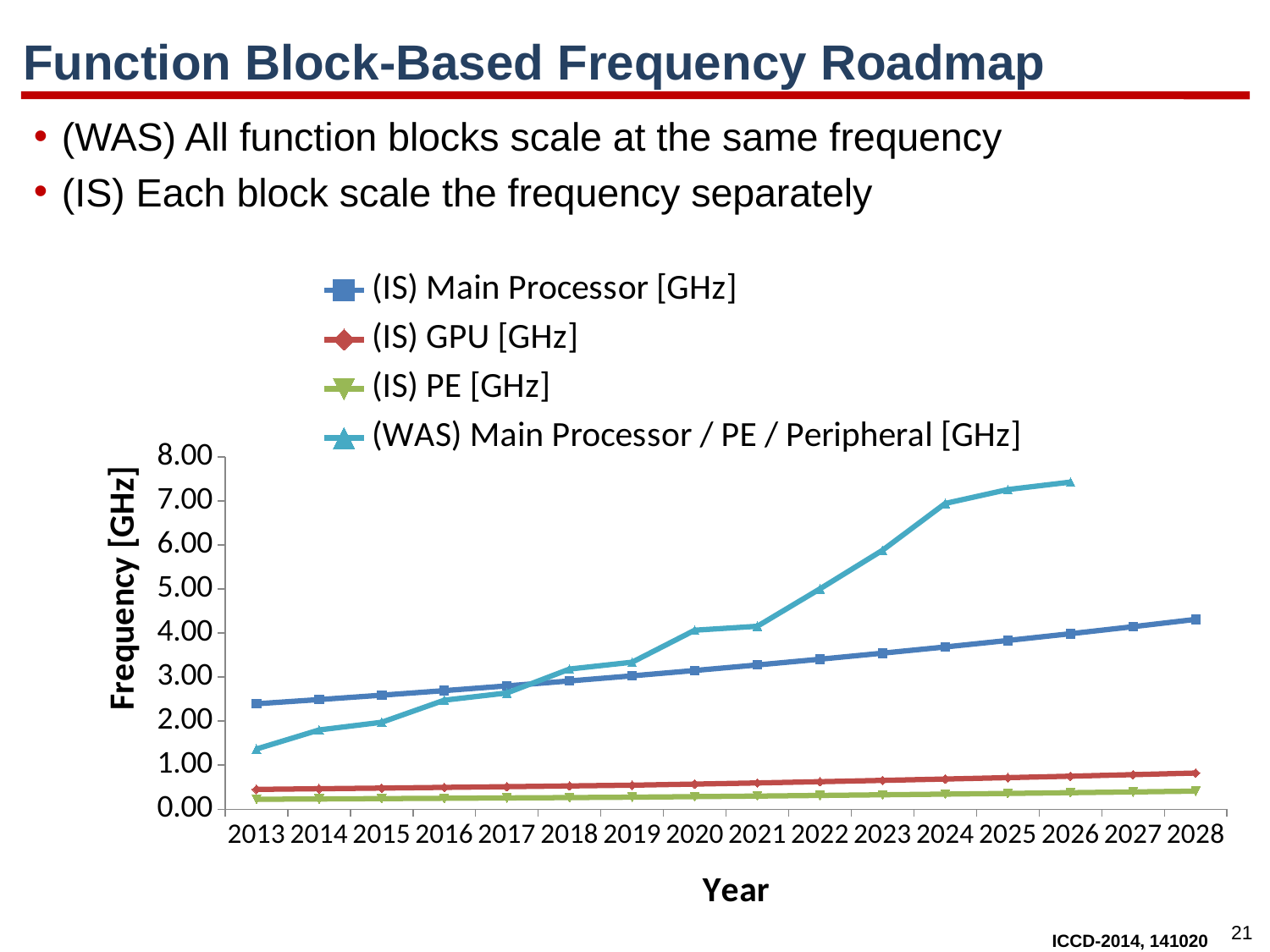
Is the value for (IS) GPU [GHz] in 2028 greater or less than 1.00? less In 2026, which is larger: (WAS) Main Processor / PE / Peripheral [GHz] or (IS) Main Processor [GHz]? (WAS) Main Processor / PE / Peripheral [GHz] Is the value for (WAS) Main Processor / PE / Peripheral [GHz] in 2013 greater or less than 2.00? less How many series does the chart legend list? 4 Is the value for (IS) Main Processor [GHz] in 2028 greater or less than 4.00? greater What kind of chart is shown on the slide? Line chart What is the label of the vertical axis of the chart? Frequency [GHz] In 2013, which is larger: (IS) Main Processor [GHz] or (WAS) Main Processor / PE / Peripheral [GHz]? (IS) Main Processor [GHz] Do the values for (WAS) Main Processor / PE / Peripheral [GHz] rise or fall from 2013 to 2026? rise How many years are shown on the x axis of the chart? 16 Which series has the lowest values across all years in the chart? (IS) PE [GHz]